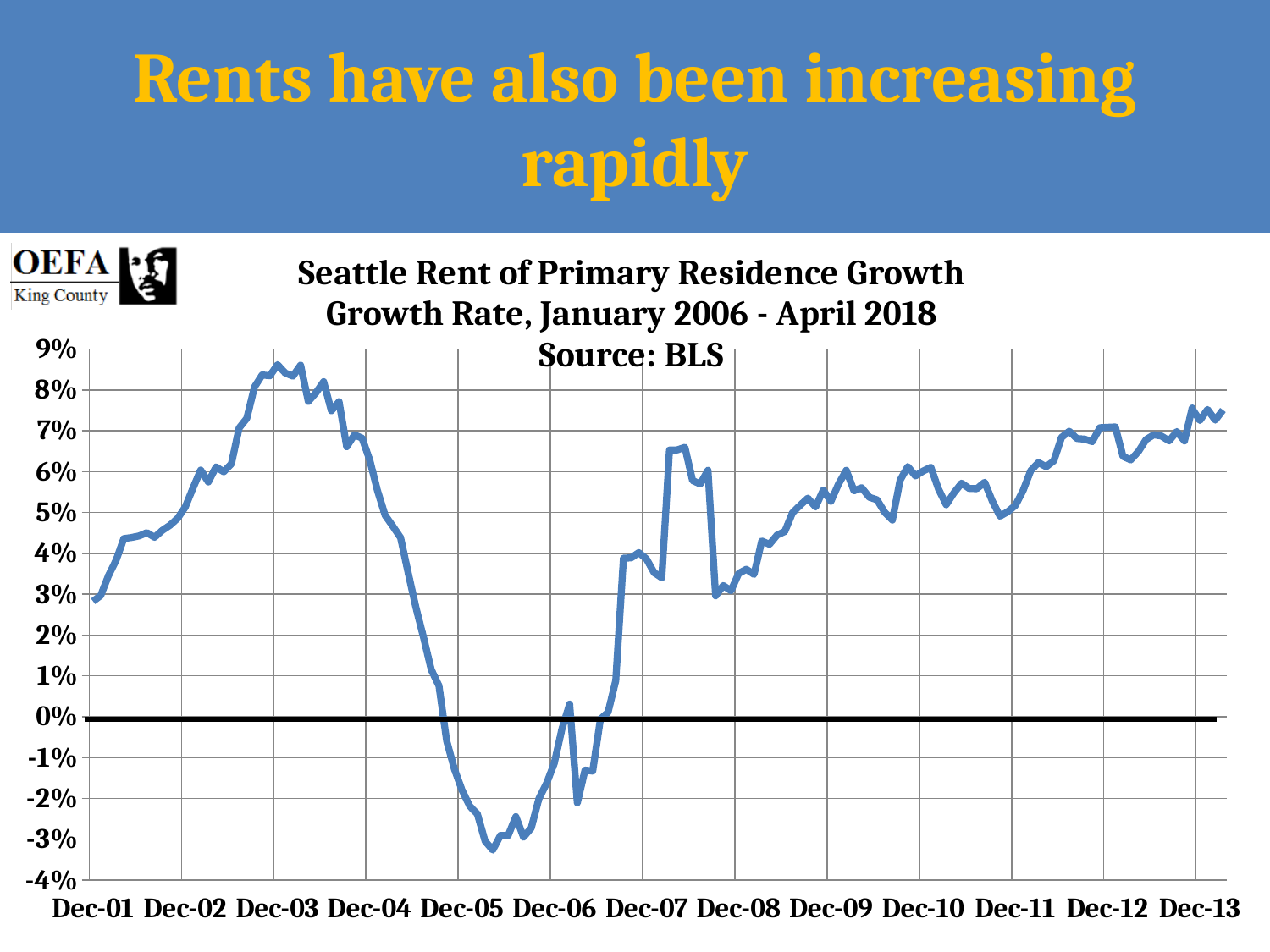
Is the value at Dec-13 greater or less than 7%? greater How many date labels are shown along the x axis? 13 What kind of chart is shown on the slide? Line chart Is the value at Dec-05 greater or less than 0%? less What is the first line of the chart's title? Seattle Rent of Primary Residence Growth Is the value at Dec-03 greater or less than 8%? greater Does the line rise or fall between Dec-06 and Dec-07? Rise Does the line rise or fall between Dec-03 and Dec-05? Fall What is the source cited in the chart title? BLS